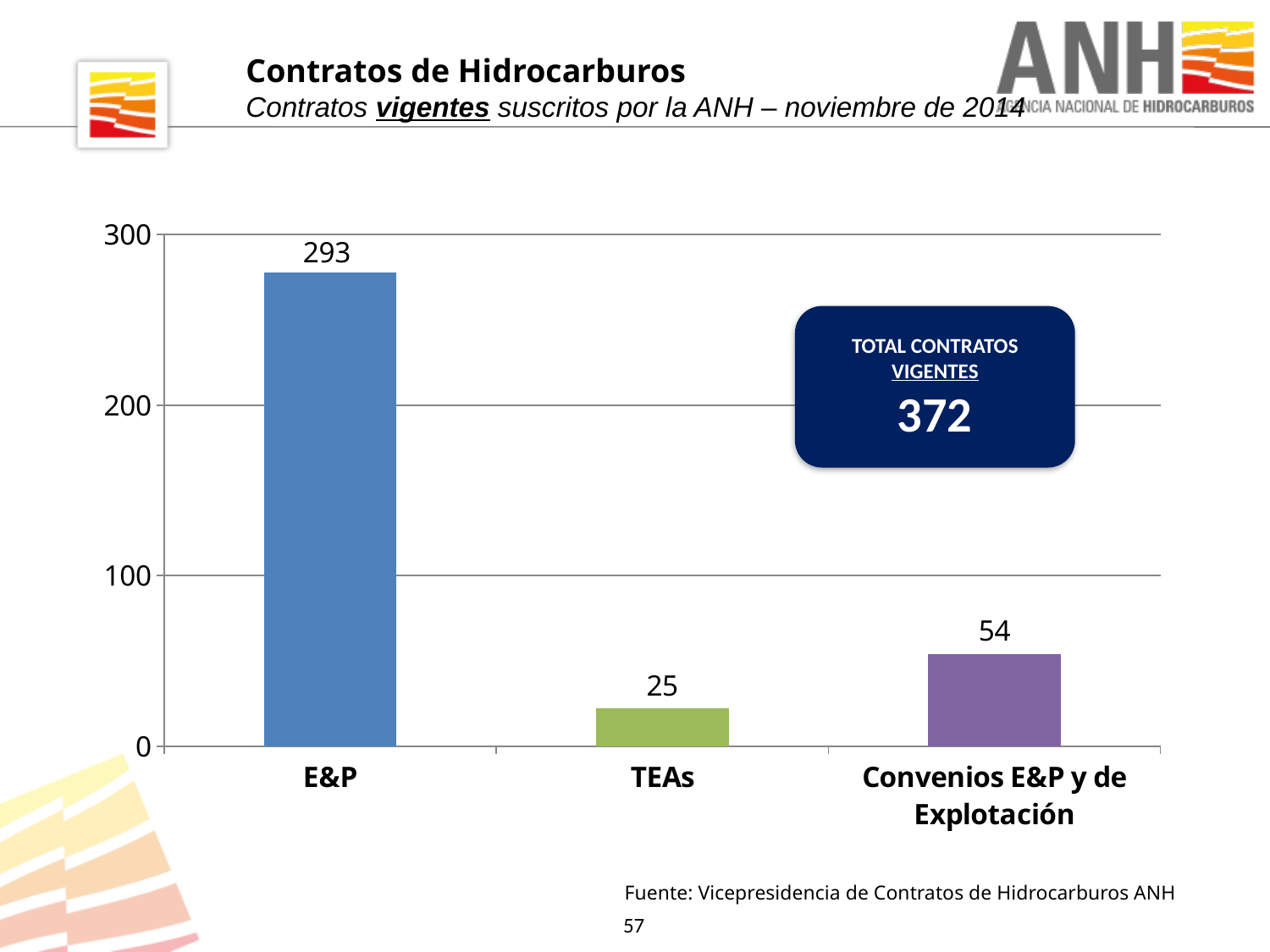
Which category has the highest value? E&P Which category has the lowest value? TEAs What kind of chart is shown on the slide? bar chart What is the difference between the values for Convenios E&P y de Explotación and TEAs? 29 How many categories are shown on the chart? 3 What is the value for Convenios E&P y de Explotación? 54 Is the value for E&P greater or less than 200? greater What is the value for TEAs? 25 What is the difference between the values for E&P and Convenios E&P y de Explotación? 239 What is the value for E&P? 293 Which is larger, the value for TEAs or the value for Convenios E&P y de Explotación? Convenios E&P y de Explotación What total number of contratos vigentes is shown in the box on the chart? 372